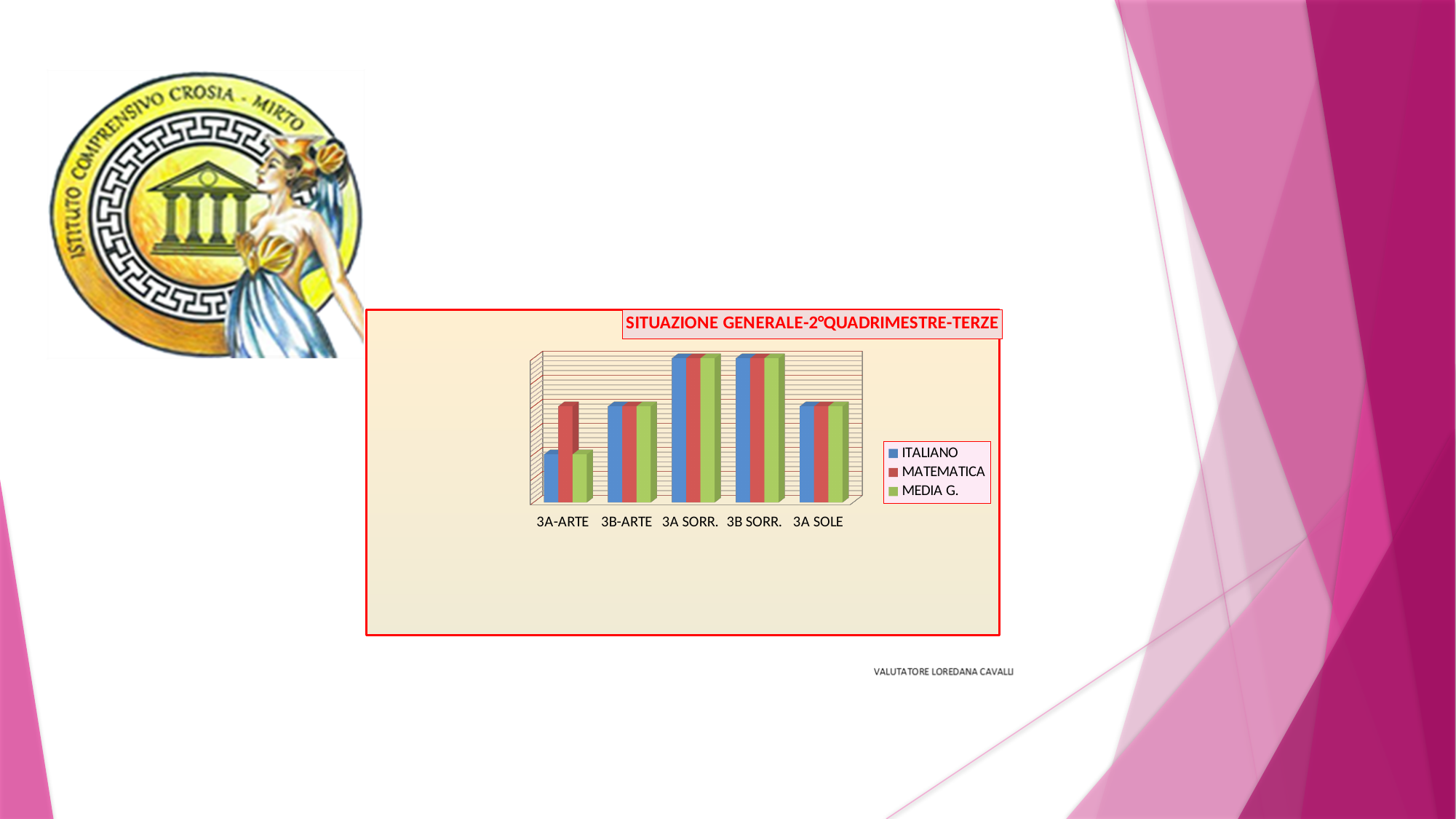
Which series is shown in green in the chart? MEDIA G. What kind of chart is shown on the slide? Bar chart How many series does the legend list? 3 Which is larger: the MATEMATICA bar for 3A SORR. or the MATEMATICA bar for 3B-ARTE? 3A SORR. What is the title of the chart? SITUAZIONE GENERALE-2°QUADRIMESTRE-TERZE Which category has the lowest ITALIANO bar? 3A-ARTE For 3A-ARTE, which is larger: the ITALIANO bar or the MATEMATICA bar? MATEMATICA How many categories are shown on the x axis of the chart? 5 Which is larger: the MEDIA G. bar for 3B SORR. or the MEDIA G. bar for 3A SOLE? 3B SORR. Which category has the lowest MEDIA G. bar? 3A-ARTE